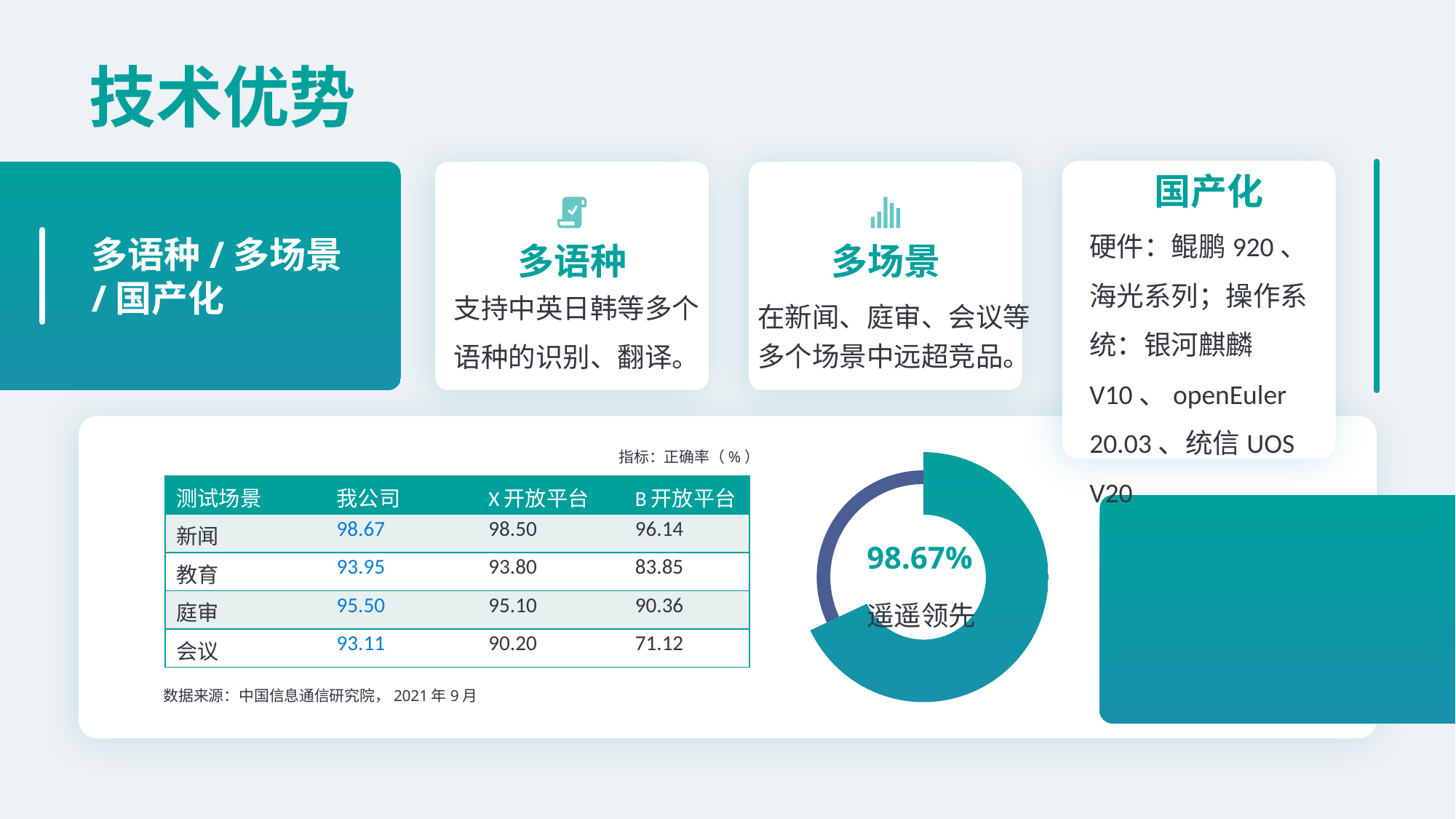
How many slices does the donut chart have? 2 What text appears below the percentage in the centre of the donut chart? 遥遥领先 What percentage value is printed in the centre of the donut chart? 98.67% What kind of chart is shown on the right side of the slide, next to the table? Donut (pie) chart In the donut chart, which slice is larger: the teal slice or the dark blue slice? The teal slice What colour is the large slice of the donut chart? Teal